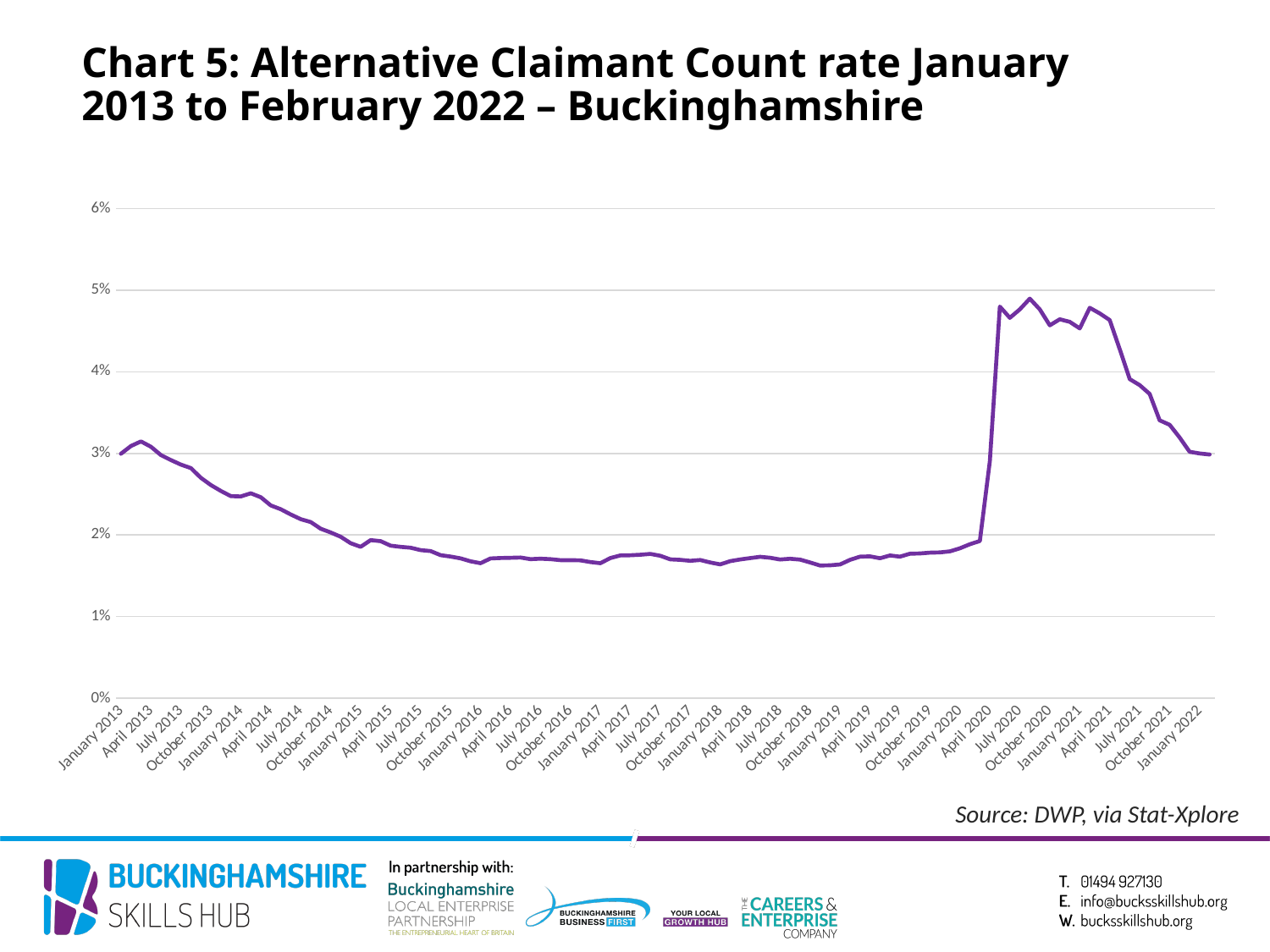
Which is larger, the value for January 2013 or the value for January 2018? January 2013 Which is larger, the value for July 2020 or the value for January 2016? July 2020 What is the title of the chart? Chart 5: Alternative Claimant Count rate January 2013 to February 2022 – Buckinghamshire Does the claimant count rate rise or fall between January 2013 and January 2016? fall What kind of chart is shown on the slide? line chart In which year does the line reach its highest point? 2020 Is the value for January 2016 greater or less than 2%? less Is the value for July 2020 greater or less than 4%? greater Is the value for January 2013 greater or less than 2%? greater How many lines are plotted on the chart? 1 What source is cited for the chart? DWP, via Stat-Xplore